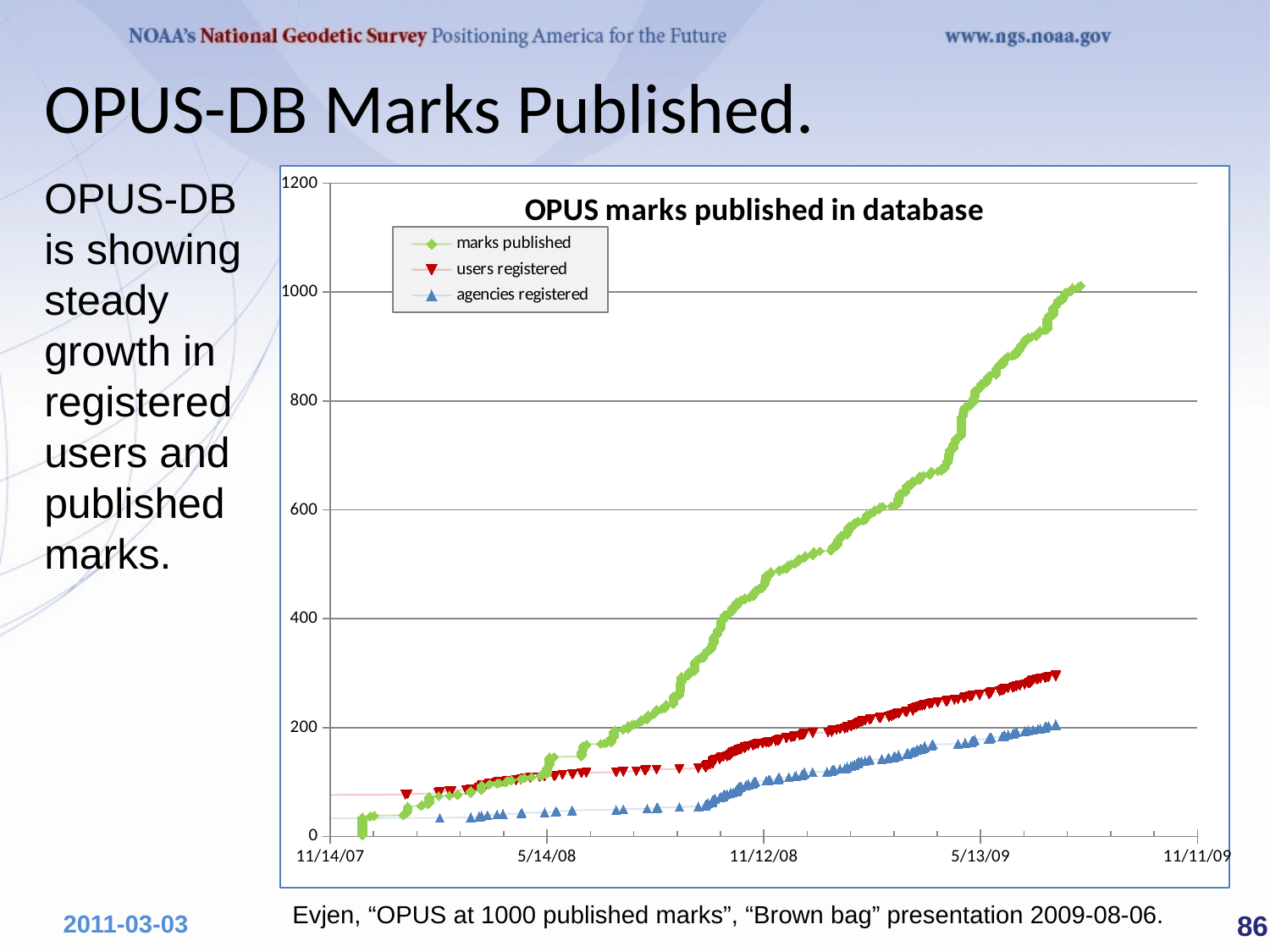
Do the values for marks published rise or fall over time along the x axis? rise Is the final value for users registered greater or less than 400? less How many series does the chart legend list? 3 Which series reaches the highest value on the chart? marks published Is the final value for agencies registered greater or less than 400? less What kind of chart is shown on the slide? line chart Is the value for users registered at 5/13/09 greater or less than 200? greater What is the title of the chart? OPUS marks published in database What colour is used for the marks published series? green Which series has the lowest values on the chart? agencies registered Which series is higher at the end of the plotted period, users registered or agencies registered? users registered